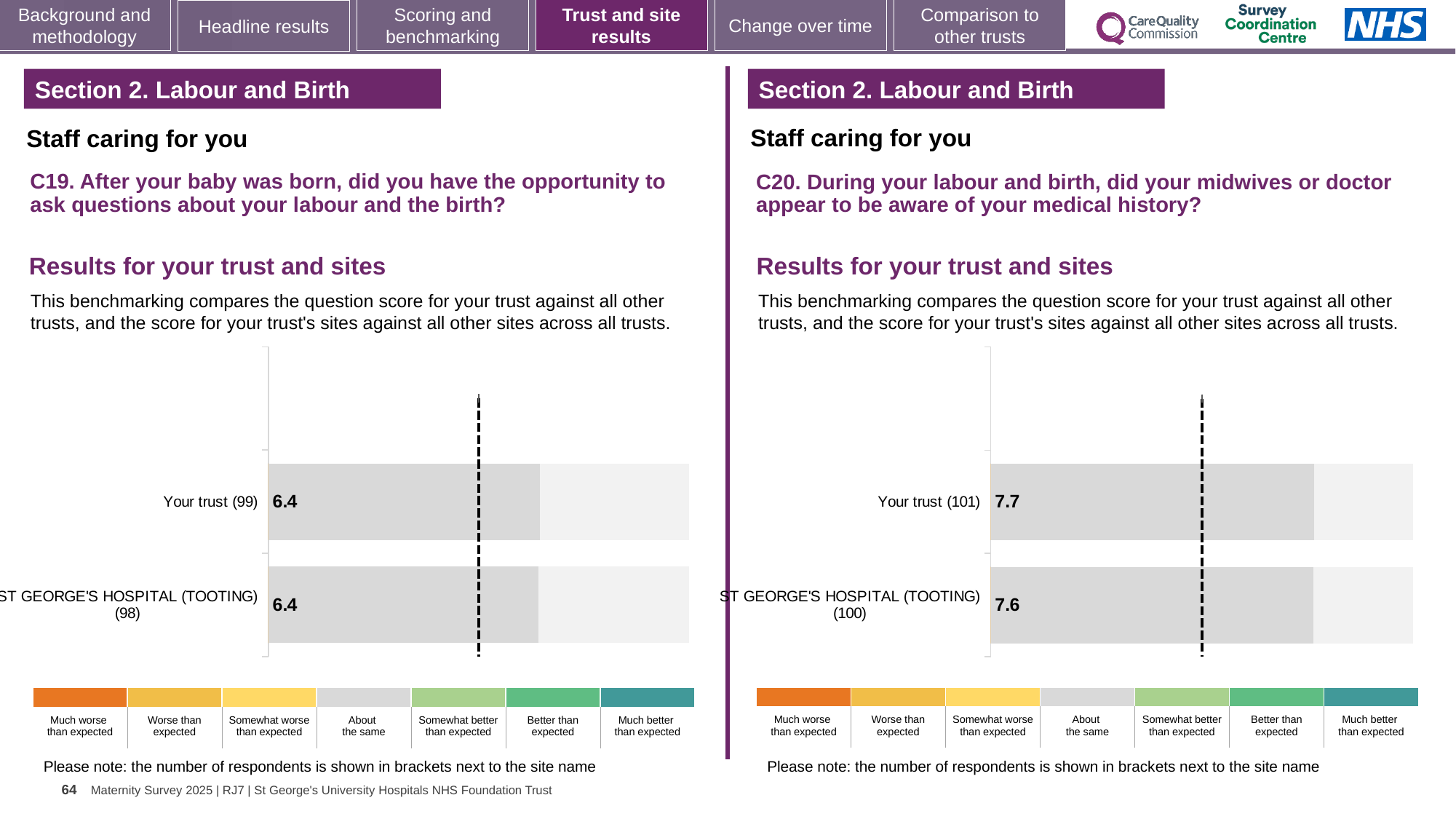
How many bars are plotted on the C19 chart (left)? 2 On the C20 chart (right), how many respondents are shown in brackets for ST GEORGE'S HOSPITAL (TOOTING)? 100 On the C20 chart (right), what is the score for Your trust (101)? 7.7 On the C20 chart (right), which has the higher score: Your trust (101) or ST GEORGE'S HOSPITAL (TOOTING) (100)? Your trust (101) On the C19 chart (left), what is the score for Your trust (99)? 6.4 On the C20 chart (right), what is the difference between the score for Your trust (101) and the score for ST GEORGE'S HOSPITAL (TOOTING) (100)? 0.1 On the C19 chart (left), what is the difference between the score for Your trust (99) and the score for ST GEORGE'S HOSPITAL (TOOTING) (98)? 0 On the C19 chart (left), what is the score for ST GEORGE'S HOSPITAL (TOOTING) (98)? 6.4 What type of chart is used for the C19 results (left)? Bar chart How many bars are plotted on the C20 chart (right)? 2 How many categories does the colour legend below the C19 chart (left) list? 7 On the C20 chart (right), what is the score for ST GEORGE'S HOSPITAL (TOOTING) (100)? 7.6